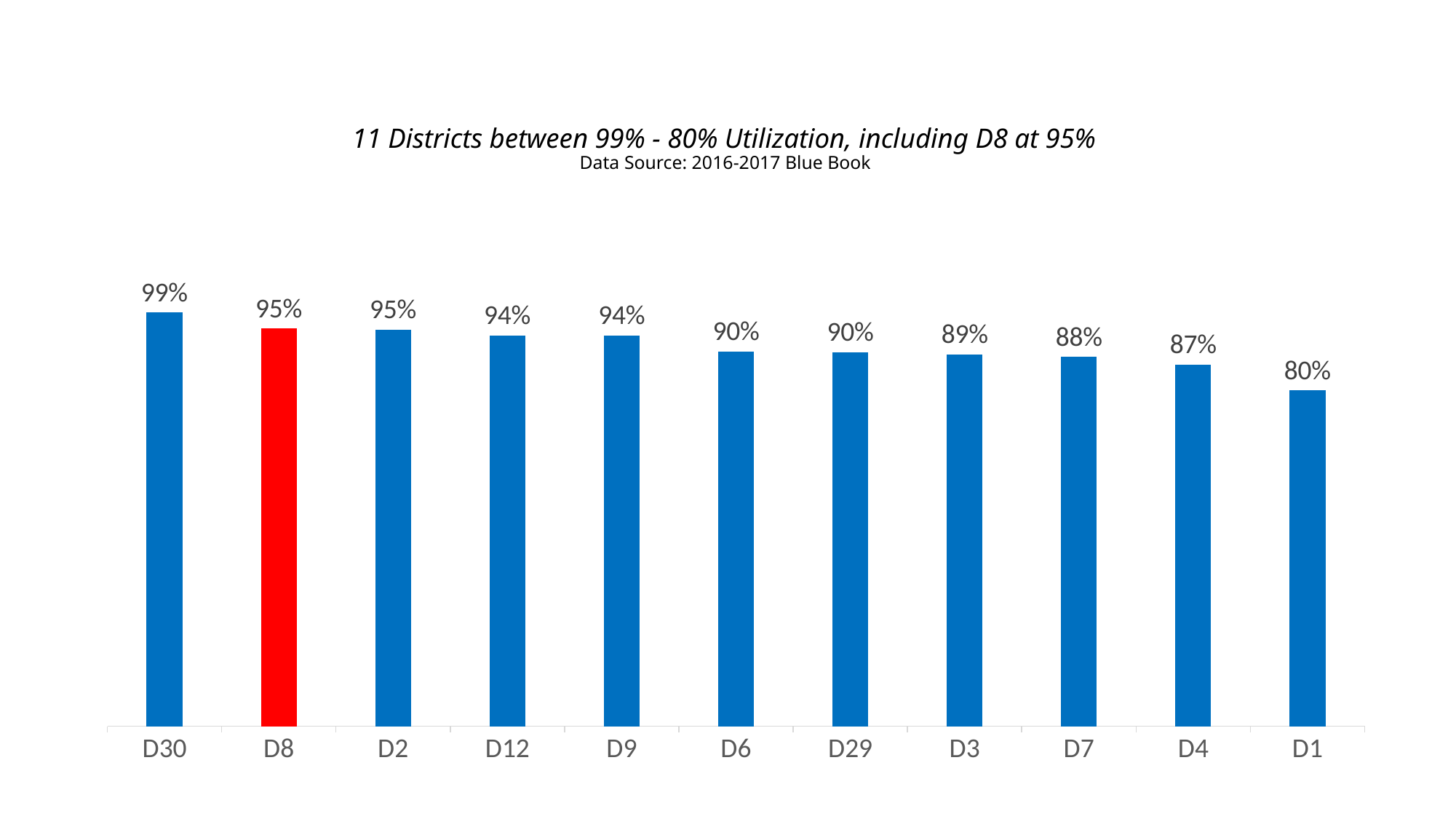
Which has a higher utilization, D12 or D3? D12 How many districts are shown in the chart? 11 Which district's bar is coloured red? D8 Which district has the highest utilization? D30 What is the utilization value for D7? 88% What is the utilization value for D8? 95% Which district has the lowest utilization? D1 What is the difference between the utilization of D30 and D1? 19% Do the values rise or fall from left to right along the x axis? Fall What is the utilization value for D30? 99% What kind of chart is shown on the slide? Bar chart What is the difference between the utilization of D8 and D4? 8%